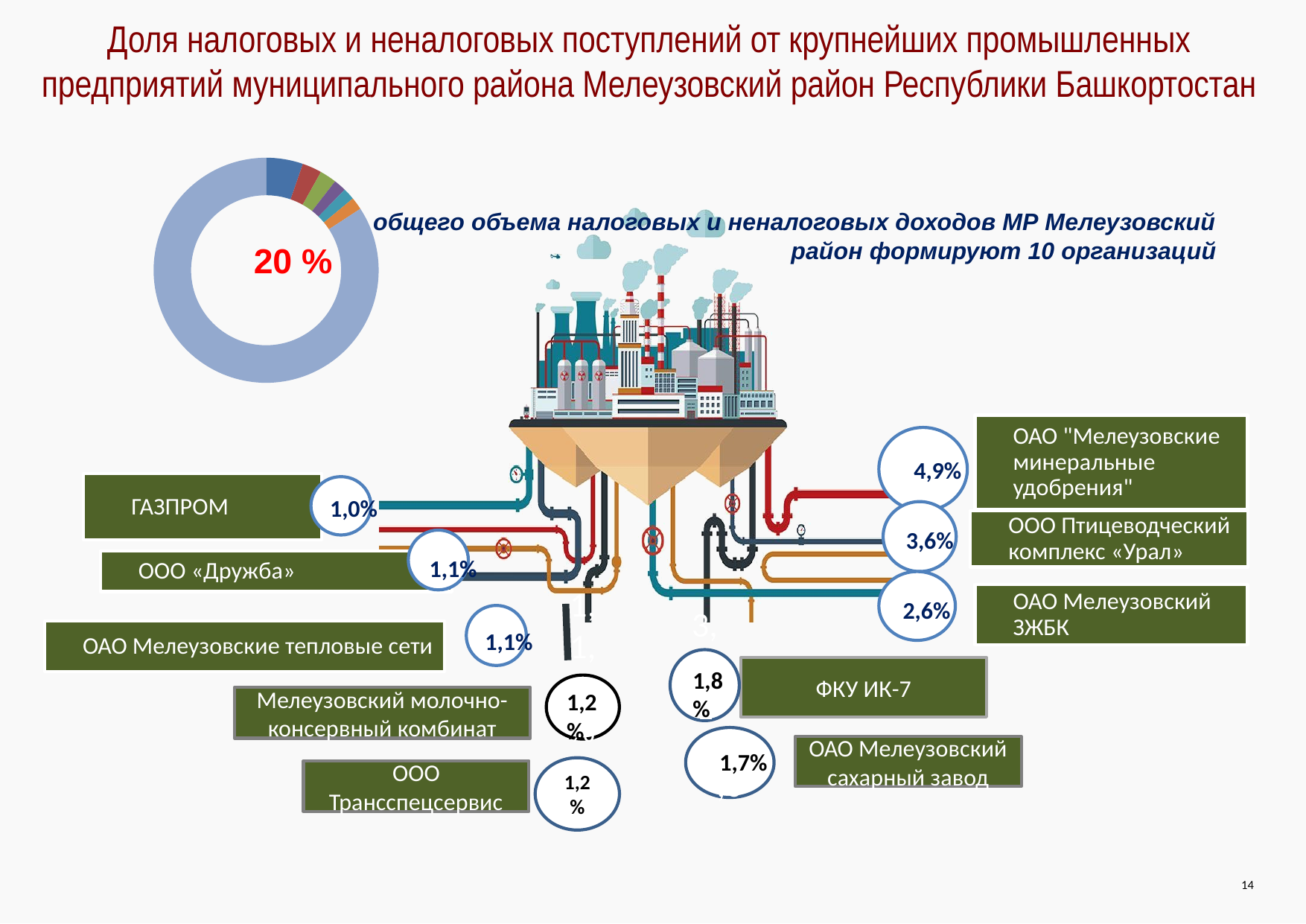
What share is shown for ОАО Мелеузовский сахарный завод? 1,7% What share is shown for ФКУ ИК-7? 1,8% What kind of chart is shown on the left of the slide? Donut (pie) chart What is the difference between the shares of ОАО "Мелеузовские минеральные удобрения" and ООО Птицеводческий комплекс «Урал»? 1,3% Which organization has the lowest share shown on the slide? ГАЗПРОМ What share is shown for ООО Птицеводческий комплекс «Урал»? 3,6% What percentage is printed in the centre of the donut chart? 20 % According to the text next to the donut chart, how many organizations form the 20 % share of tax and non-tax revenues? 10 What share is shown for ГАЗПРОМ? 1,0% Which has the larger share: ОАО Мелеузовский ЗЖБК or ФКУ ИК-7? ОАО Мелеузовский ЗЖБК What share is shown for ОАО "Мелеузовские минеральные удобрения"? 4,9% Which organization has the highest share shown on the slide? ОАО "Мелеузовские минеральные удобрения"